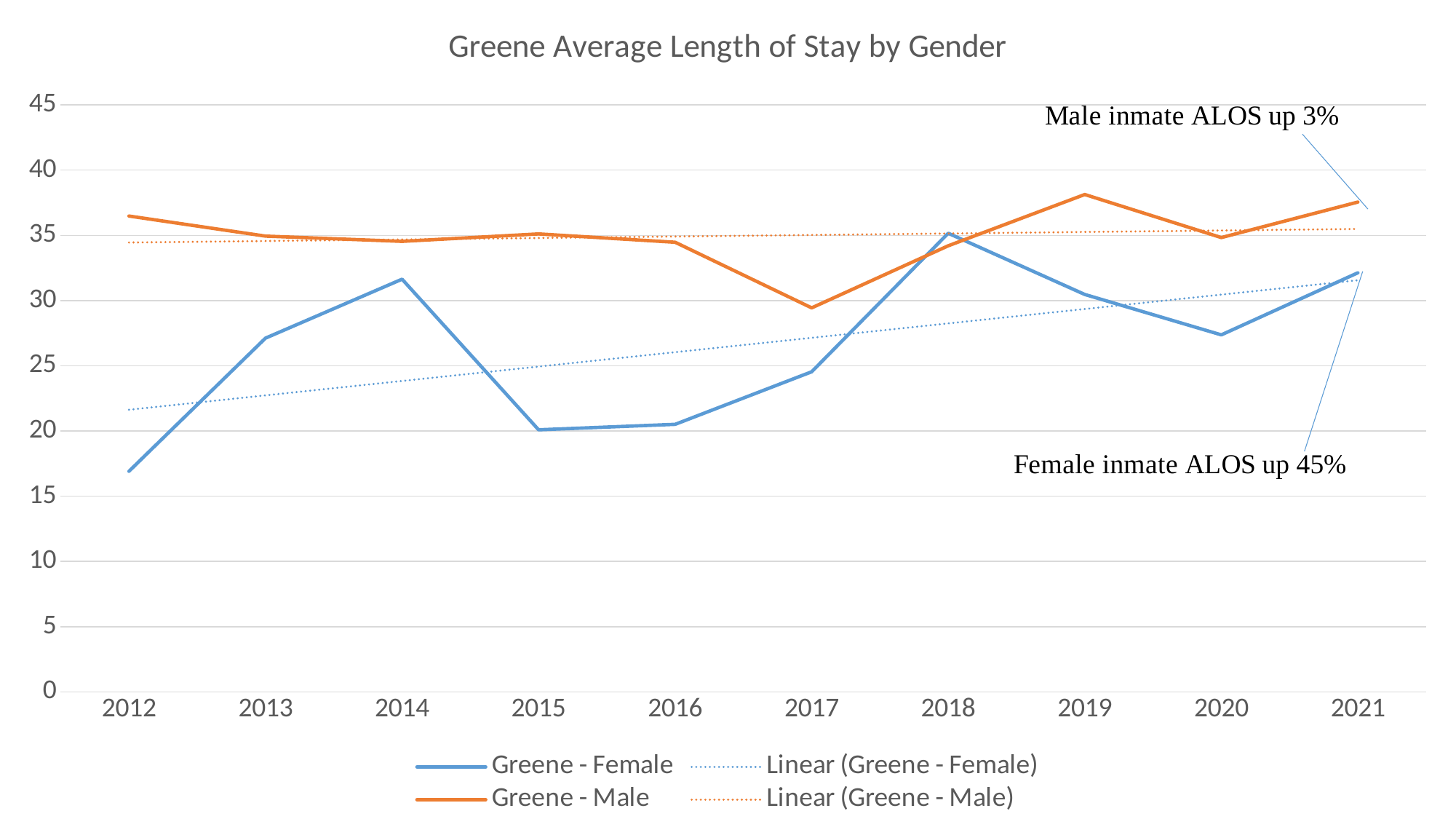
In which year is the Greene - Female value highest? 2018 Is the Greene - Male value for 2019 greater or less than 35? greater In 2012, which series has the larger value, Greene - Female or Greene - Male? Greene - Male Is the Greene - Male value for 2017 greater or less than 30? less In which year is the Greene - Male value lowest? 2017 According to the annotation on the chart, by what percentage is female inmate ALOS up? 45% In which year is the Greene - Female value lowest? 2012 What is the title of the chart? Greene Average Length of Stay by Gender What type of chart is shown on the slide? Line chart How many entries does the legend list? 4 How many years are shown on the x axis? 10 Is the Greene - Female value for 2012 greater or less than 20? less